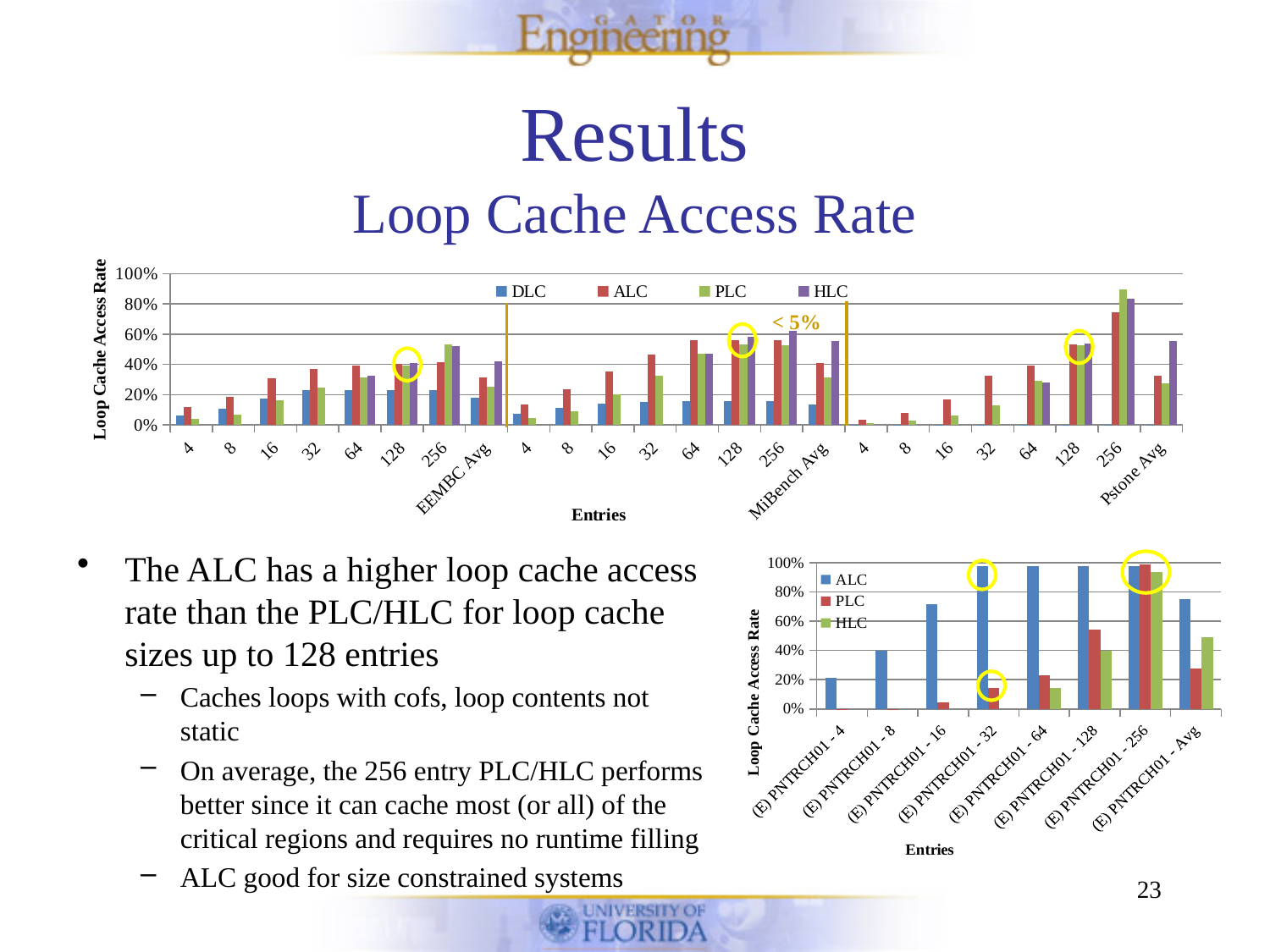
In the top chart, does the ALC access rate rise or fall as EEMBC entries increase from 4 to 256? rise In the bottom-right chart, which is larger for (E) PNTRCH01 - 128, the ALC value or the PLC value? ALC In the top chart, which series has the highest bar for Pstone 256 entries? PLC How many series does the legend of the top chart list? 4 How many series does the legend of the bottom-right chart list? 3 How many categories are shown on the x axis of the bottom-right chart? 8 In the top chart, is the PLC value for Pstone 256 entries greater or less than 80%? greater In the top chart, is the HLC value for MiBench Avg greater or less than 40%? greater In the bottom-right chart, is the ALC value for (E) PNTRCH01 - 64 greater or less than 80%? greater In the top chart, what are the four series named in the legend? DLC, ALC, PLC, HLC What kind of chart is the top chart on the slide? bar chart